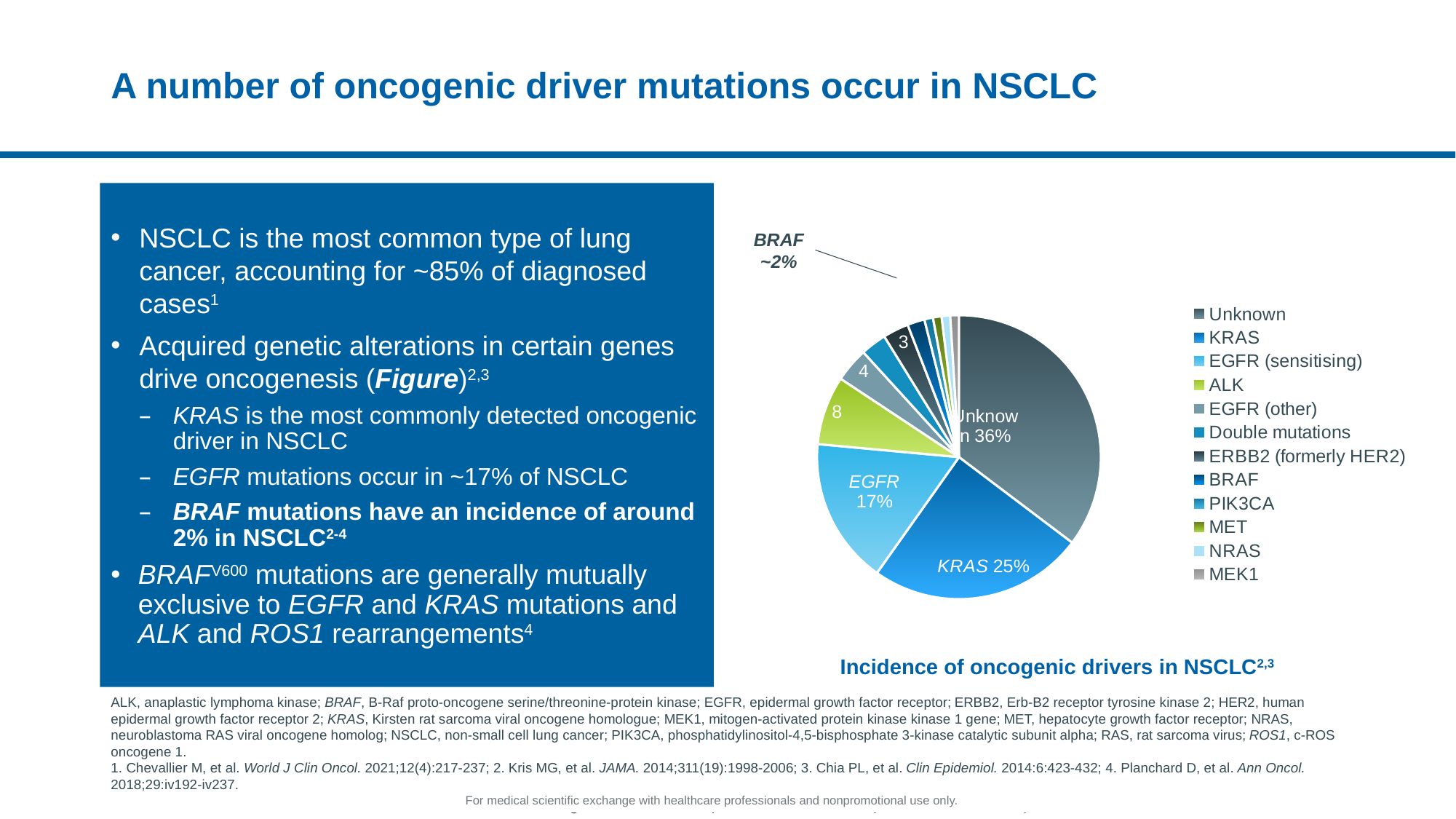
Which slice is larger, KRAS or EGFR (sensitising)? KRAS How many entries does the chart legend list? 12 What share of the pie is EGFR (sensitising)? 17% What value is printed on the ALK slice? 8 What share of the pie is KRAS? 25% By how many percentage points does the Unknown slice exceed the KRAS slice? 11 What kind of chart is shown on the slide? Pie chart What is the title of the chart? Incidence of oncogenic drivers in NSCLC What share is given for BRAF in the chart callout? ~2% Which category has the largest slice of the pie? Unknown What share of the pie is labelled Unknown? 36% What value is printed on the EGFR (other) slice? 4